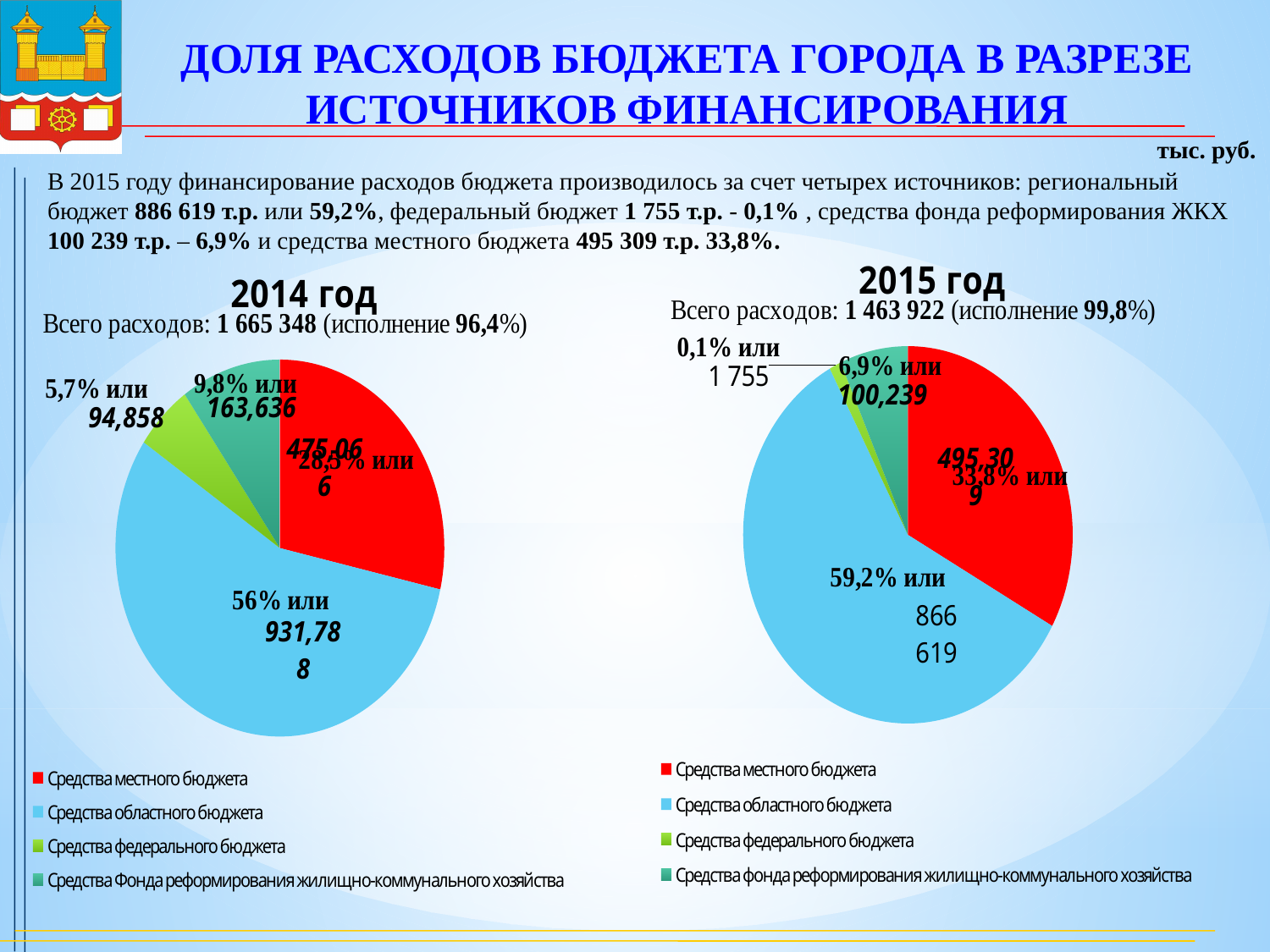
In the 2014 год chart, which is larger: the share of Средства Фонда реформирования жилищно-коммунального хозяйства or the share of Средства федерального бюджета? Средства Фонда реформирования жилищно-коммунального хозяйства How many slices does the 2014 год pie chart have? 4 In the 2015 год chart, what percentage share is shown for Средства местного бюджета? 33,8% In the 2015 год chart, what colour represents Средства областного бюджета? light blue In the 2014 год chart, what value is shown for Средства федерального бюджета? 94,858 In the 2015 год chart, what value is shown for Средства федерального бюджета? 1 755 In the 2015 год chart, which source has the smallest slice? Средства федерального бюджета In the 2014 год chart, what percentage share is shown for Средства областного бюджета? 56% In the 2015 год chart, what is the difference in percentage points between the share of Средства областного бюджета and the share of Средства местного бюджета? 25,4% What kind of chart is used for the 2014 год chart? pie chart How many entries does the legend of the 2015 год chart list? 4 In the 2015 год chart, which source has the largest slice? Средства областного бюджета